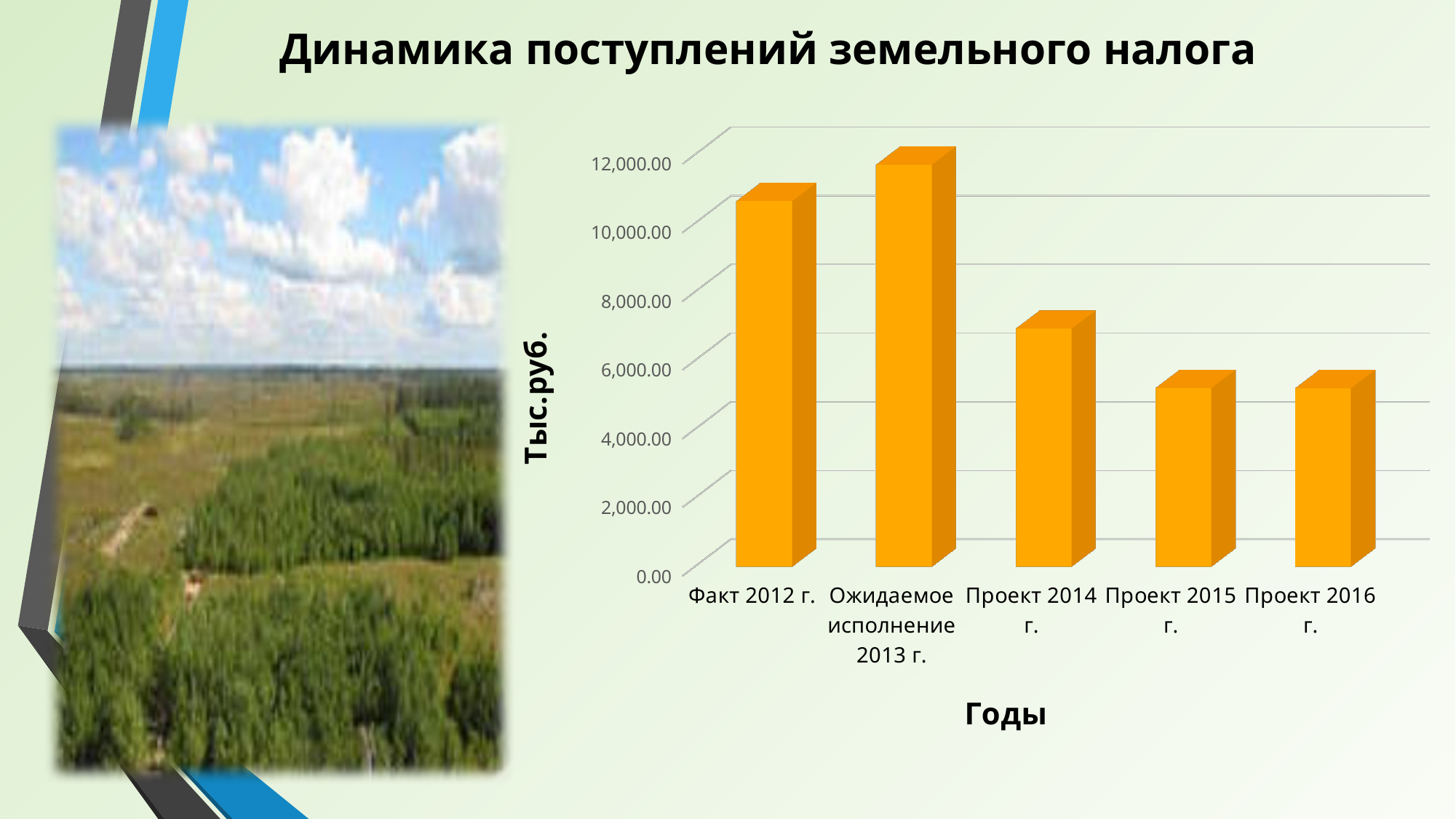
What is the label of the vertical axis of the chart? Тыс.руб. From Ожидаемое исполнение 2013 г. to Проект 2015 г., do the values rise or fall? fall Is the value for Проект 2014 г. greater or less than 8,000.00? less Is the value for Факт 2012 г. greater or less than 10,000.00? greater Which category has the highest value in the chart? Ожидаемое исполнение 2013 г. How many categories are shown on the x axis of the chart? 5 Is the value for Проект 2016 г. greater or less than 4,000.00? greater What is the title of the chart? Динамика поступлений земельного налога What kind of chart is shown on the slide? bar chart Which is larger, the value for Факт 2012 г. or the value for Проект 2014 г.? Факт 2012 г.